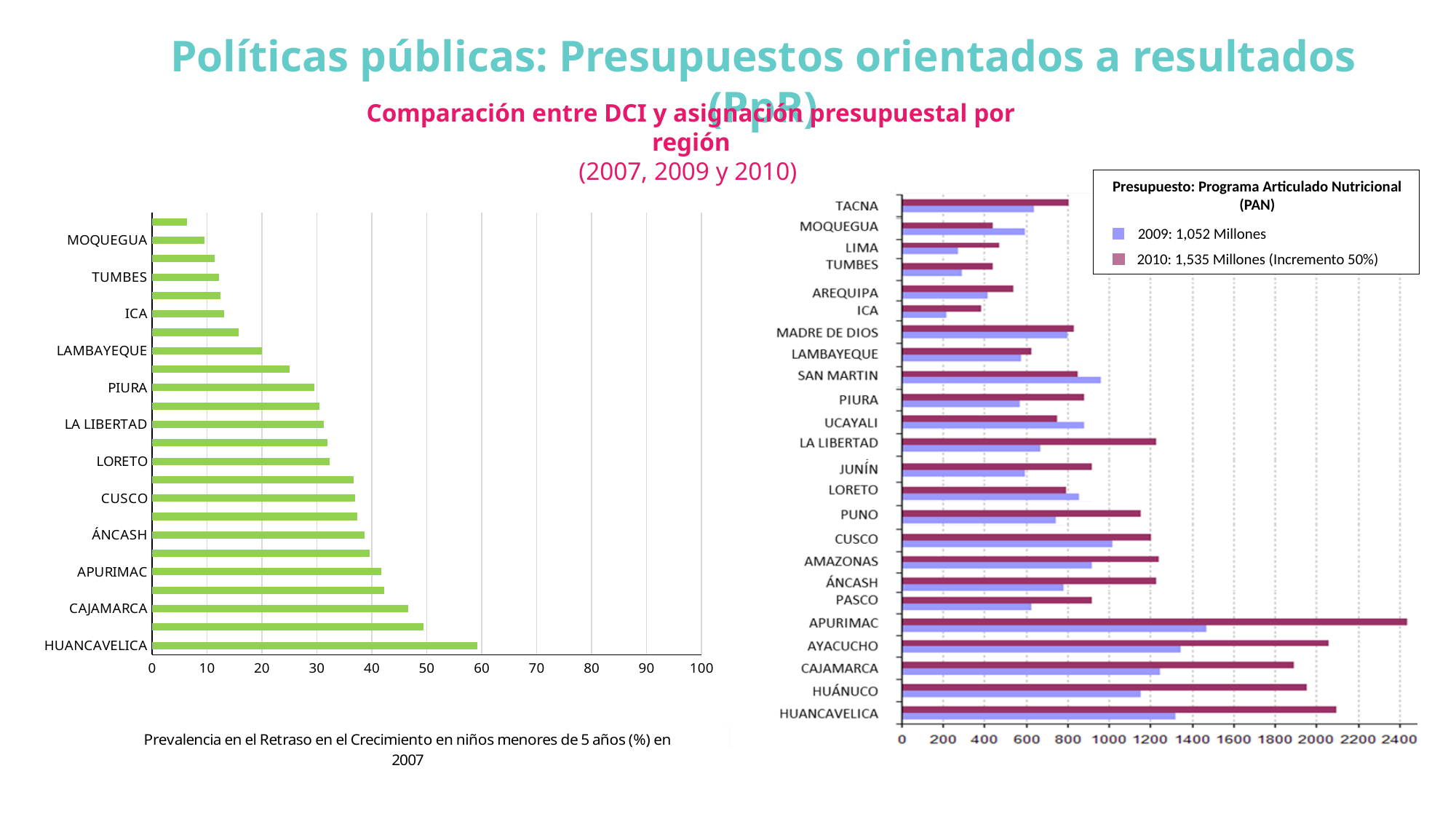
In the left chart (Prevalencia en el Retraso en el Crecimiento), which is larger, the value for HUANCAVELICA or the value for ICA? HUANCAVELICA In the left chart (Prevalencia en el Retraso en el Crecimiento), is the value for MOQUEGUA greater or less than 20? less In the left chart (Prevalencia en el Retraso en el Crecimiento), is the value for HUANCAVELICA greater or less than 50? greater In the right chart (Presupuesto: Programa Articulado Nutricional), which region has the highest 2010 value? APURIMAC In the left chart (Prevalencia en el Retraso en el Crecimiento), is the value for CUSCO greater or less than 30? greater What kind of chart is the left chart (Prevalencia en el Retraso en el Crecimiento)? bar chart According to the legend of the right chart, what total budget is given for 2010? 1,535 Millones (Incremento 50%) How many series does the legend of the right chart (Presupuesto: Programa Articulado Nutricional) list? 2 How many regions are shown in the right chart (Presupuesto: Programa Articulado Nutricional)? 24 In the right chart (Presupuesto: Programa Articulado Nutricional), which is larger for LA LIBERTAD, the 2009 value or the 2010 value? 2010 In the left chart (Prevalencia en el Retraso en el Crecimiento), which region has the highest value? HUANCAVELICA